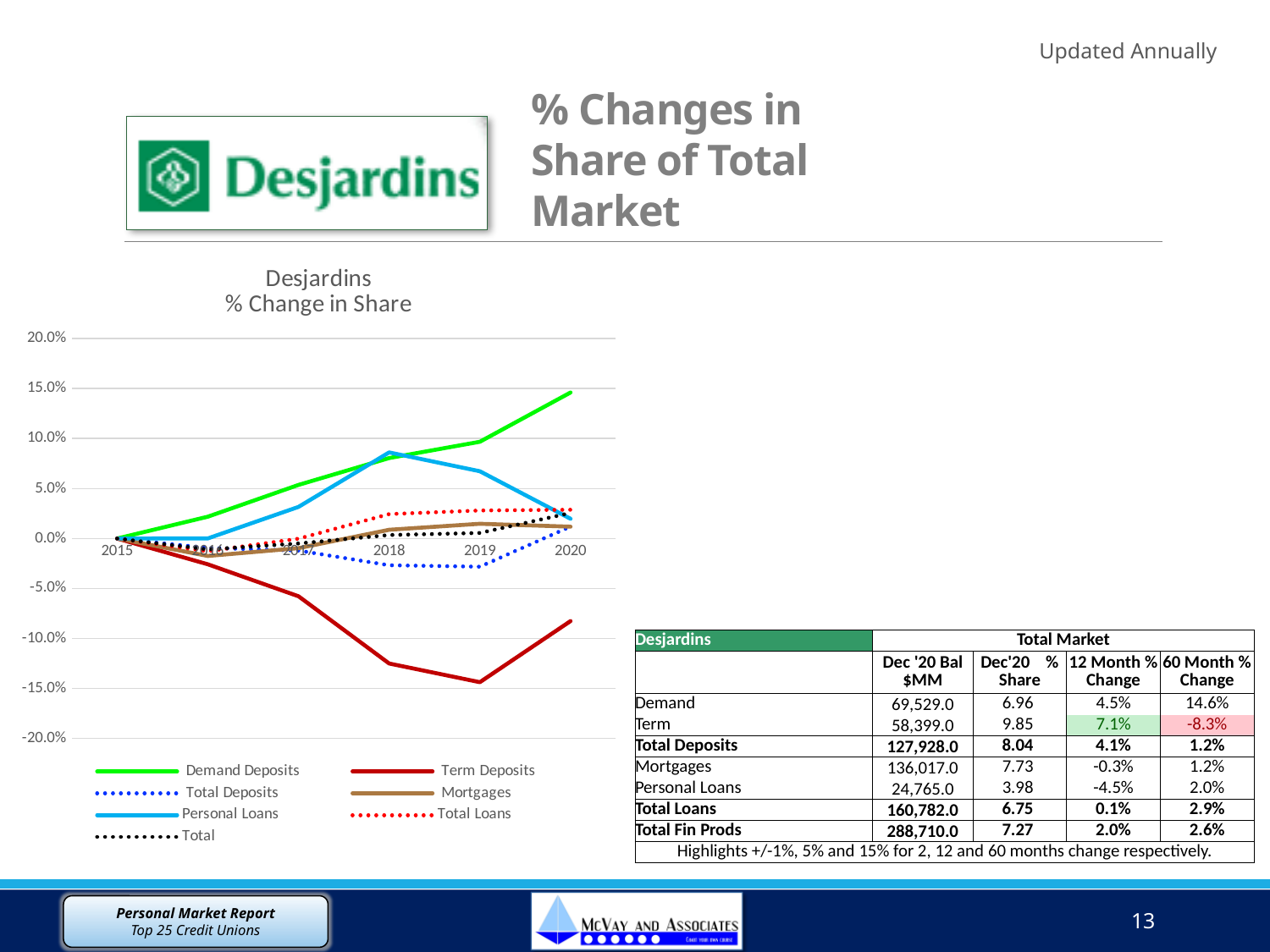
In which year does the Term Deposits line reach its lowest point? 2019 Is the value for Personal Loans in 2018 greater or less than 5.0%? greater Is the value for Term Deposits in 2019 greater or less than -10.0%? less Which series has the lowest value in 2020? Term Deposits How many years are plotted along the x axis of the chart? 6 Which is larger in 2020, Demand Deposits or Personal Loans? Demand Deposits Does the Demand Deposits line rise or fall from 2015 to 2020? rise In which year does the Demand Deposits line reach its highest point? 2020 Is the value for Demand Deposits in 2020 greater or less than 10.0%? greater What kind of chart is shown on the slide? line chart Which series has the highest value in 2020? Demand Deposits How many series does the chart legend list? 7